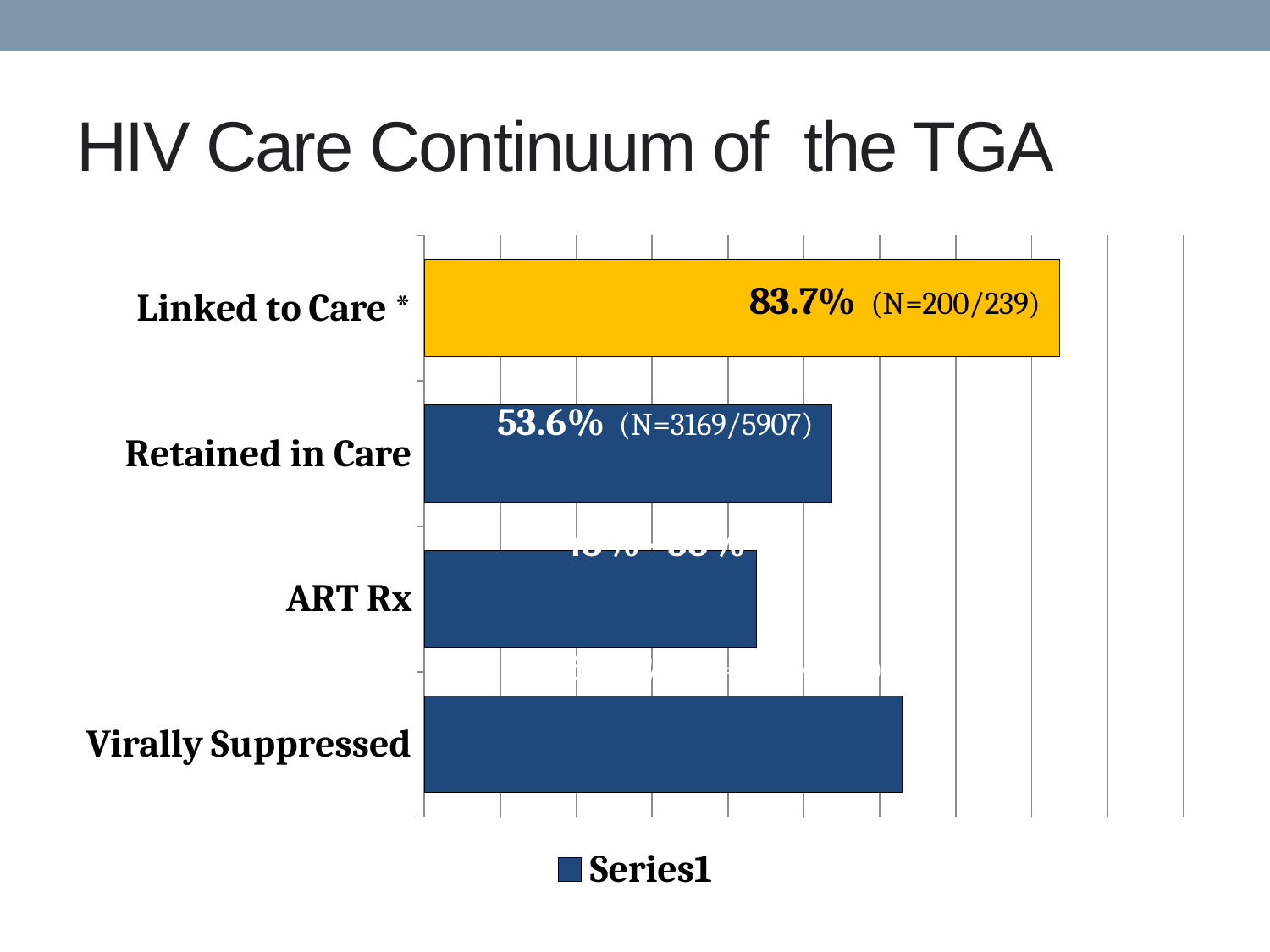
How many series does the legend list? 1 How many categories are shown in the chart? 4 What N fraction is shown next to the Linked to Care * bar? N=200/239 Which category has the shortest bar? ART Rx What is the difference between the Linked to Care * value and the Retained in Care value? 30.1 percentage points What is the value shown for Linked to Care *? 83.7% What N fraction is shown next to the Retained in Care bar? N=3169/5907 Which category has the highest value? Linked to Care * What is the title of the slide? HIV Care Continuum of the TGA Which is larger, the bar for Virally Suppressed or the bar for ART Rx? Virally Suppressed What kind of chart is shown on the slide? Bar chart What is the value shown for Retained in Care? 53.6%